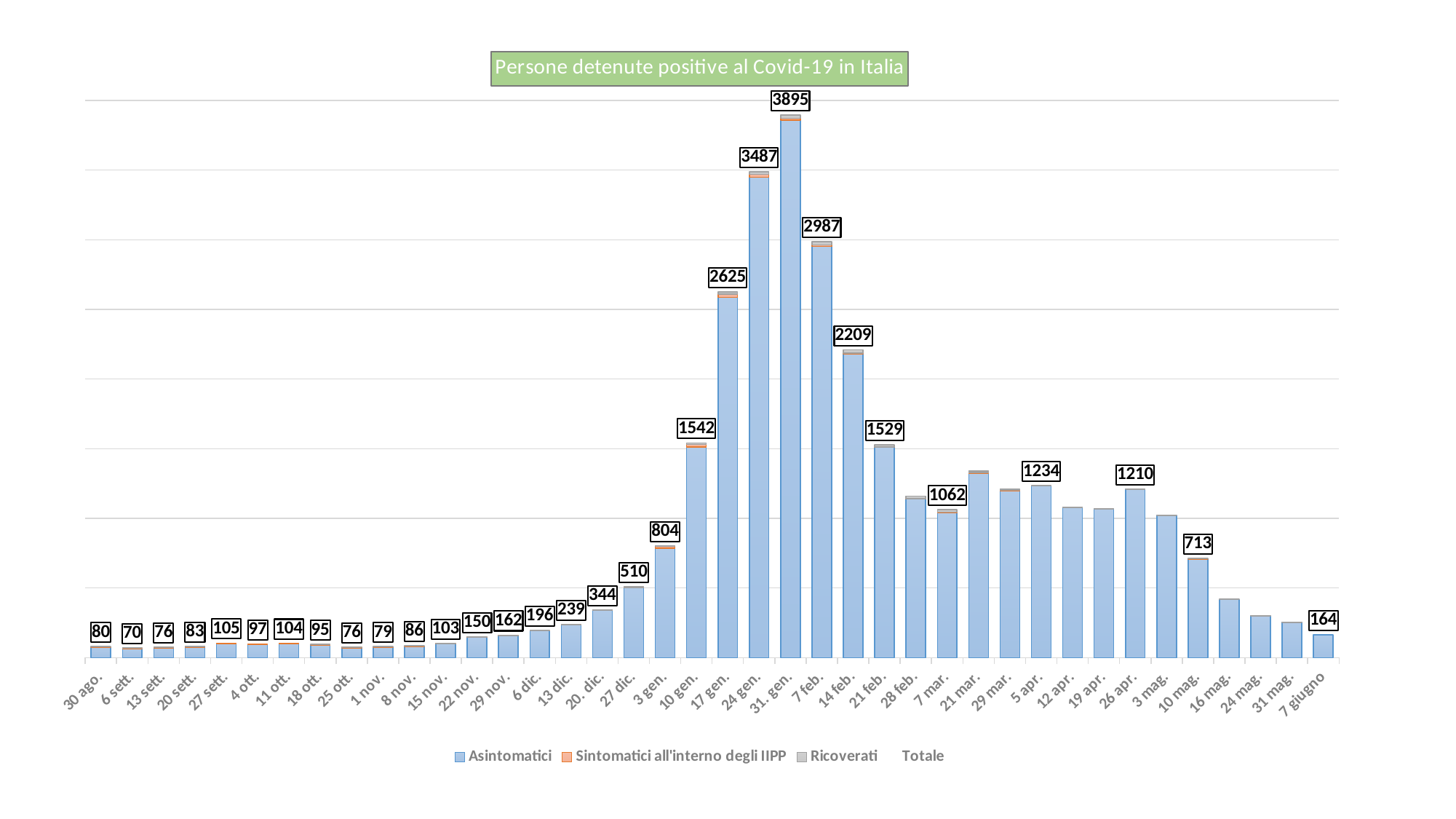
What is the total value labelled for 7 giugno? 164 Which date has the highest total of positive detainees? 31 gen. What is the difference between the totals for 7 feb. and 14 feb.? 778 How many entries does the legend list? 4 Which date has the lowest labelled total? 6 sett. What is the title of the chart? Persone detenute positive al Covid-19 in Italia Do the totals rise or fall from 3 gen. to 31 gen.? Rise What is the total number of positive detainees shown for 31 gen.? 3895 What is the difference between the totals for 31 gen. and 24 gen.? 408 What kind of chart is shown on the slide? Stacked bar chart Which is larger, the total for 24 gen. or the total for 7 feb.? 24 gen. How many dates are shown on the x axis? 40